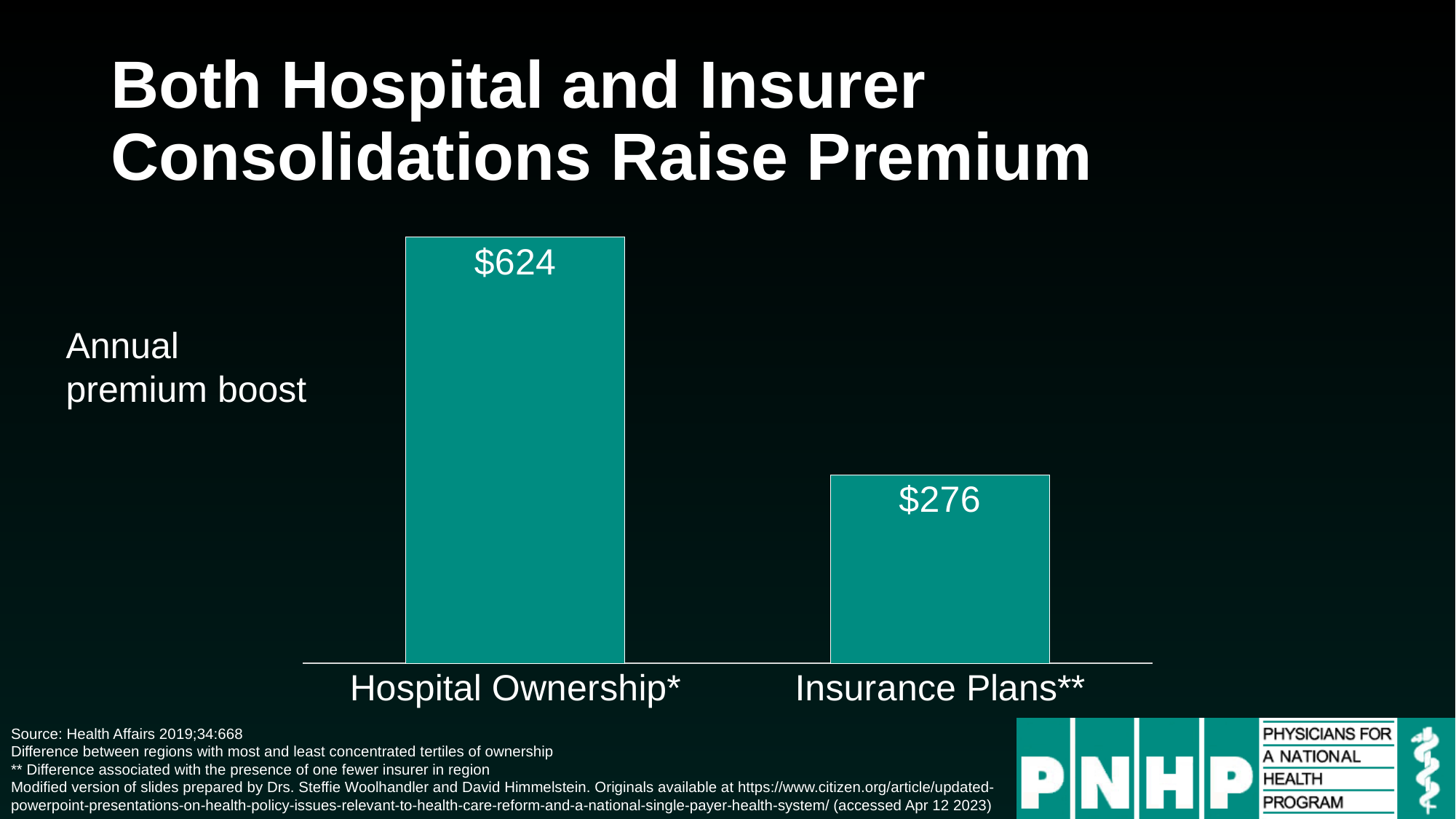
Which category has the lower annual premium boost? Insurance Plans** Which category has the higher annual premium boost? Hospital Ownership* How many categories are shown in the chart? 2 What is the title of the slide containing the chart? Both Hospital and Insurer Consolidations Raise Premium What label describes the quantity plotted by the bars? Annual premium boost Is the annual premium boost larger for Hospital Ownership* or Insurance Plans**? Hospital Ownership* What is the annual premium boost for Hospital Ownership*? $624 What is the annual premium boost for Insurance Plans**? $276 What is the difference between the annual premium boost for Hospital Ownership* and Insurance Plans**? $348 What is the total of the two annual premium boost values shown? $900 What kind of chart is shown on the slide? Bar chart